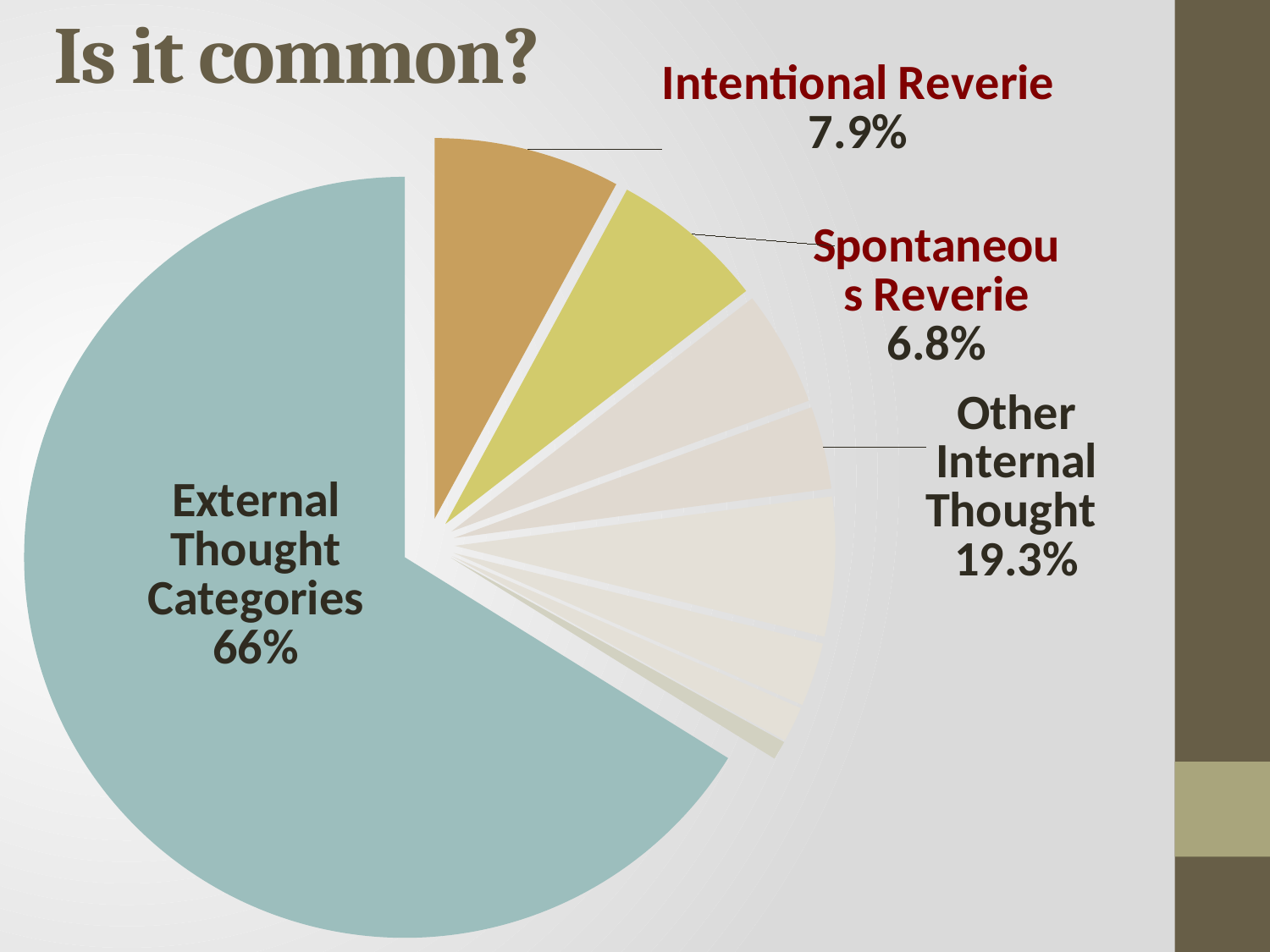
What percentage is labelled for Spontaneous Reverie? 6.8% What is the title of the slide containing the pie chart? Is it common? Which labelled category has the smallest share of the pie? Spontaneous Reverie Which is larger, Intentional Reverie or Spontaneous Reverie? Intentional Reverie What percentage is labelled for Other Internal Thought? 19.3% What is the difference in percentage points between Intentional Reverie and Spontaneous Reverie? 1.1 What is the difference in percentage points between Other Internal Thought and Intentional Reverie? 11.4 Which labelled category has the largest share of the pie? External Thought Categories How many labelled categories are shown on the pie chart? 4 What percentage is labelled for External Thought Categories? 66% What kind of chart is shown on the slide? pie chart What percentage is labelled for Intentional Reverie? 7.9%